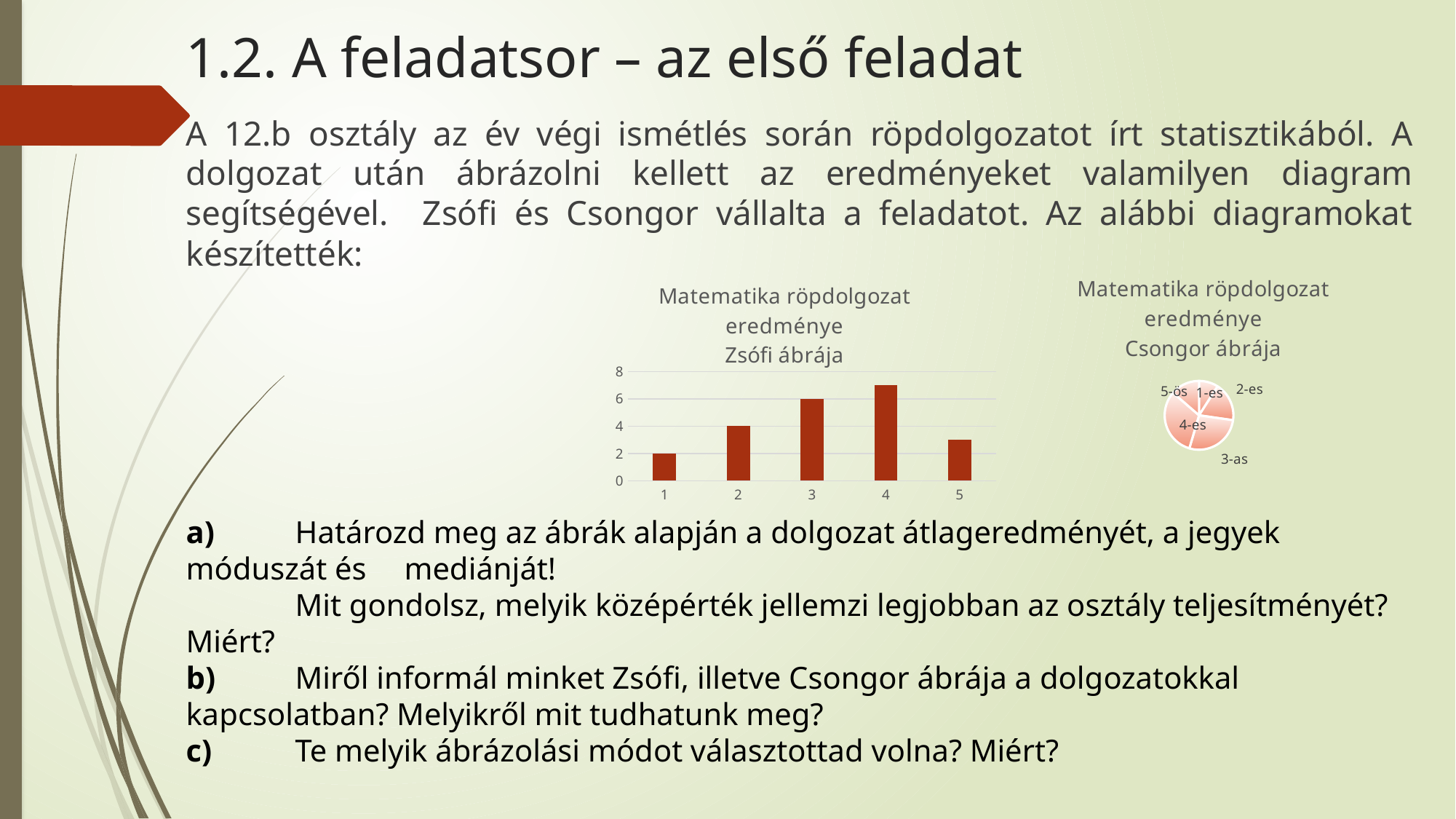
In Zsófi ábrája, is the value for category 5 greater or less than 4? less In Zsófi ábrája, what is the difference between the values for category 3 and category 1? 4 In Zsófi ábrája, what is the value for category 2? 4 In Zsófi ábrája, what is the value for category 3? 6 How many slices does the pie chart Csongor ábrája have? 5 In Zsófi ábrája, which category has the highest bar? 4 In Zsófi ábrája, which category has the lowest bar? 1 What kind of chart is Zsófi ábrája (the left chart)? bar chart In Zsófi ábrája, what is the value for category 1? 2 In Zsófi ábrája, which is larger, the value for category 2 or category 5? 2 In Zsófi ábrája, is the value for category 4 greater or less than 6? greater What kind of chart is Csongor ábrája (the right chart)? pie chart